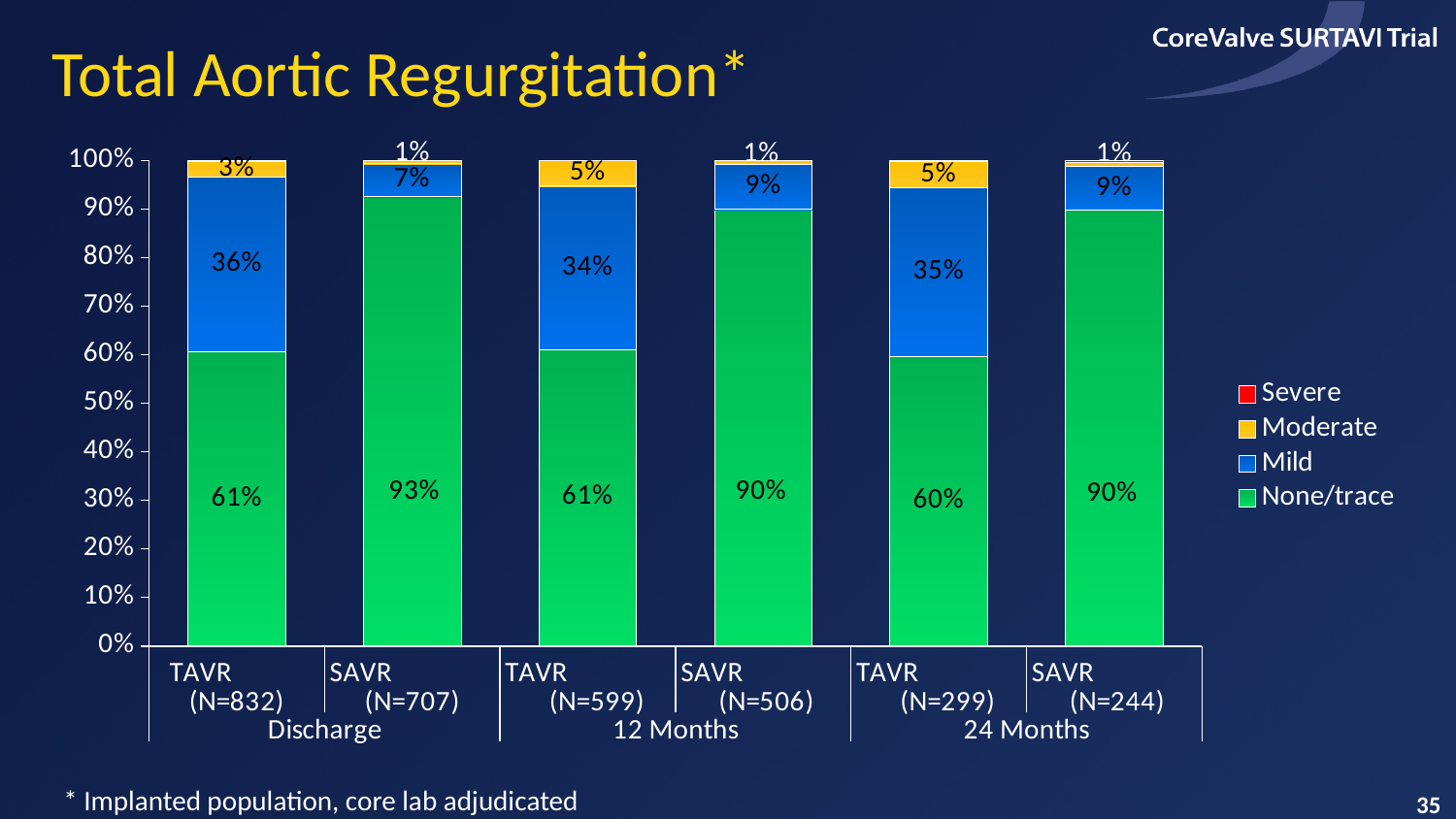
What is the None/trace value for SAVR at 24 Months? 90% How many series does the legend list? 4 What is the None/trace value for TAVR at Discharge? 61% What is the Mild value for TAVR at 24 Months? 35% Which bar has the highest None/trace value? SAVR at Discharge What kind of chart is shown on the slide? stacked bar chart Which is larger, the Mild value for TAVR at 12 Months or the Mild value for SAVR at 12 Months? TAVR at 12 Months Which bar has the lowest None/trace value? TAVR at 24 Months What is the difference between the None/trace values for SAVR and TAVR at Discharge? 32% What is the Mild value for SAVR at Discharge? 7% What is the Moderate value for TAVR at 12 Months? 5% How many bars are plotted in the chart? 6